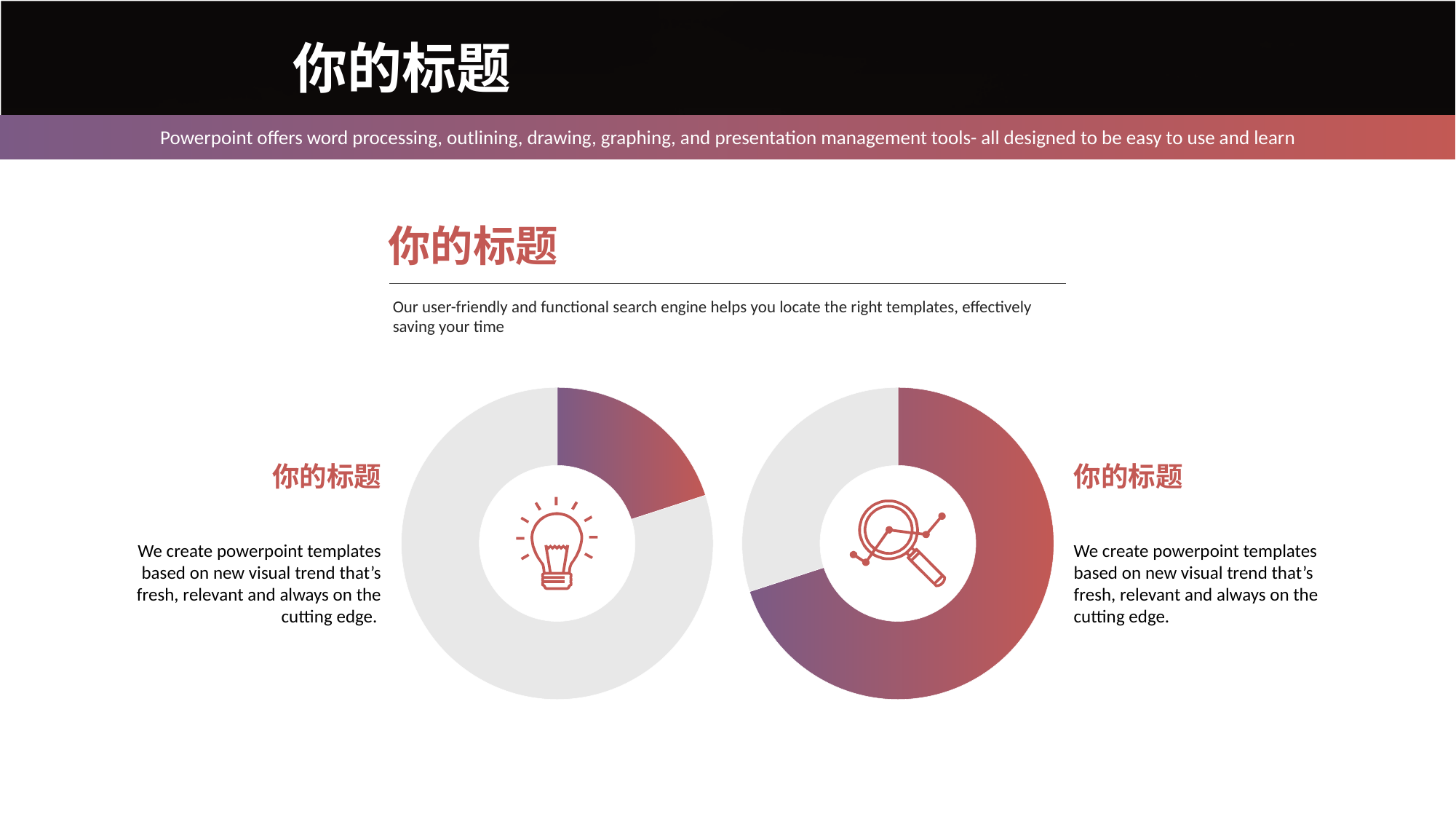
What kind of chart is the right chart on the slide? Donut chart In the right donut chart, which slice is larger, the grey slice or the coloured (purple-to-red) slice? The coloured slice Is the coloured slice of the left donut chart greater or less than half of the chart? less What icon is shown in the centre of the left donut chart? A light bulb How many slices does the left donut chart have? 2 In the left donut chart, which slice is larger, the grey slice or the coloured (purple-to-red) slice? The grey slice Is the coloured slice of the right donut chart greater or less than half of the chart? greater How many charts are shown on the slide? 2 What icon is shown in the centre of the right donut chart? A magnifying glass How many slices does the right donut chart have? 2 What kind of chart is the left chart on the slide? Donut chart